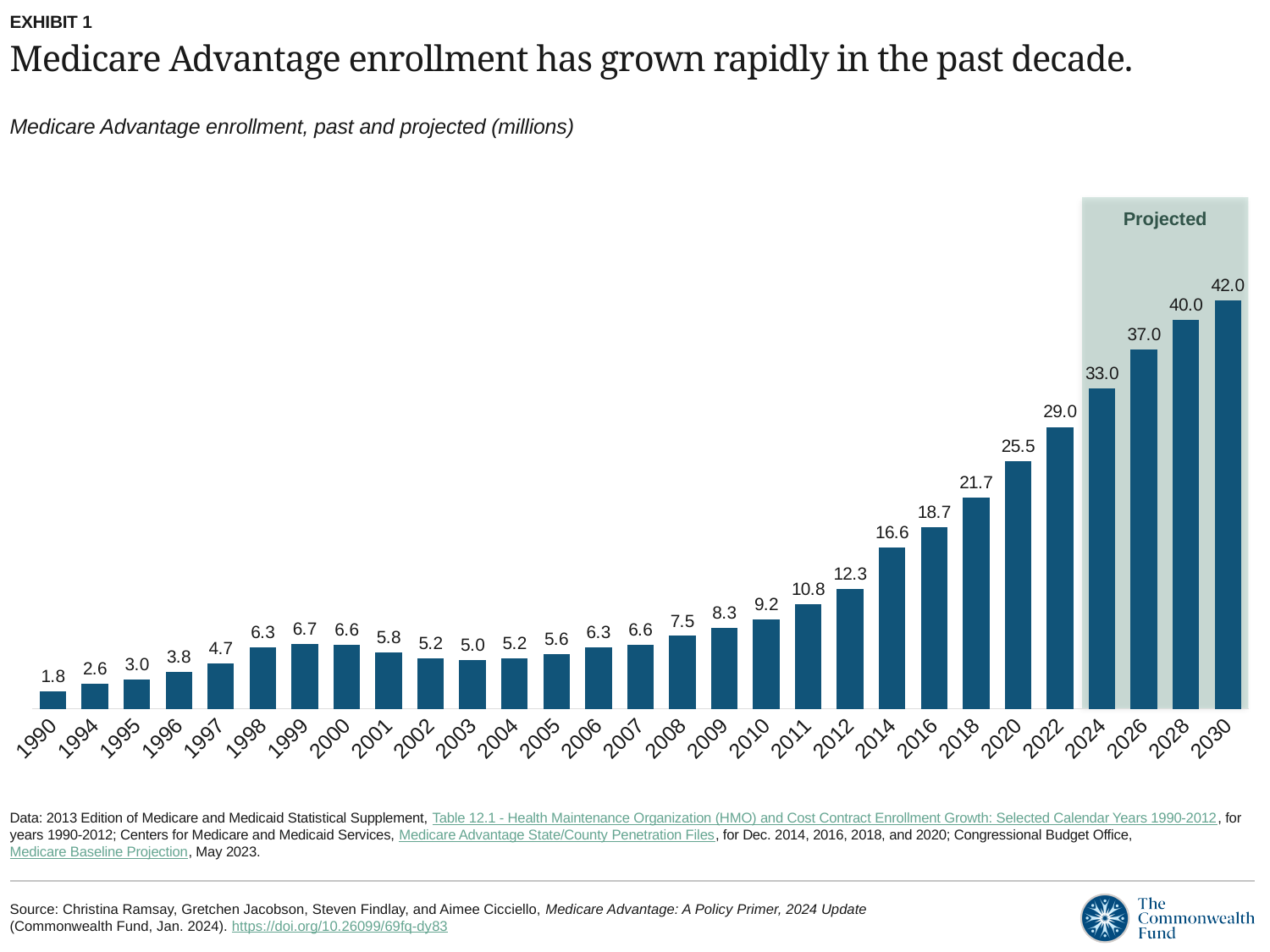
What type of chart is shown on the slide? Bar chart What is the enrollment value shown for 1999? 6.7 What label appears in the shaded area covering the bars for 2024 through 2030? Projected Which year has a larger enrollment value, 2000 or 2003? 2000 What is the difference between the enrollment values for 2022 and 2012? 16.7 What is the projected enrollment value shown for 2030? 42.0 Do the enrollment values generally rise or fall from 2009 to 2030? Rise What is the difference between the projected enrollment values for 2030 and 2024? 9.0 How many years (bars) are shown on the chart? 29 Which year has the highest enrollment value on the chart? 2030 Which year has the lowest enrollment value on the chart? 1990 What is the Medicare Advantage enrollment value shown for 2012? 12.3